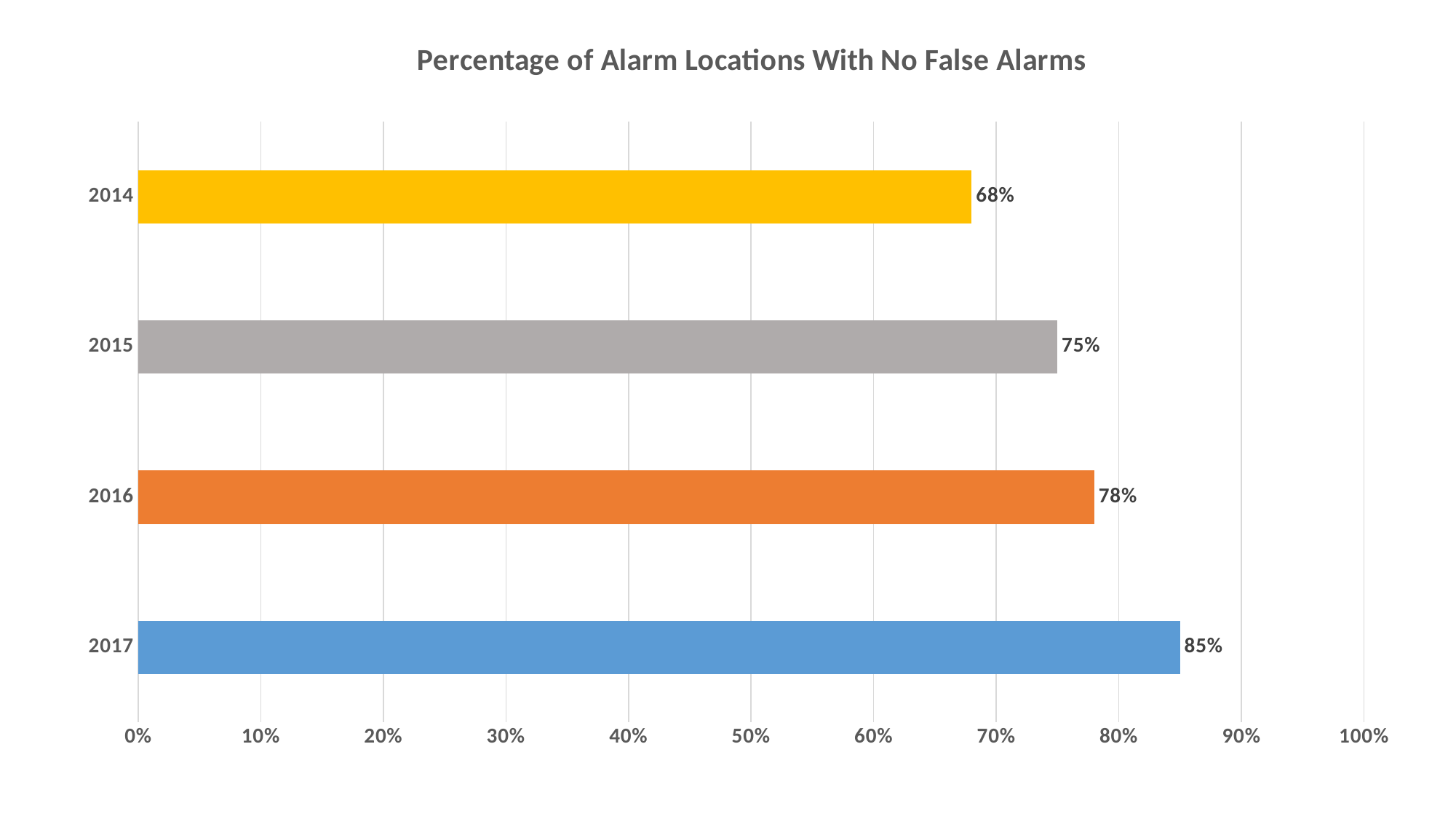
What kind of chart is shown on the slide? Bar chart How many years are shown in the chart? 4 What is the title of the chart? Percentage of Alarm Locations With No False Alarms What is the value for 2017? 85% What is the value for 2015? 75% What is the value for 2014? 68% Which year has the highest percentage of alarm locations with no false alarms? 2017 Which is larger, the value for 2016 or the value for 2015? 2016 Is the value for 2016 greater or less than 70%? greater What is the difference between the values for 2017 and 2014? 17% Which year has the lowest percentage of alarm locations with no false alarms? 2014 What is the difference between the values for 2016 and 2015? 3%